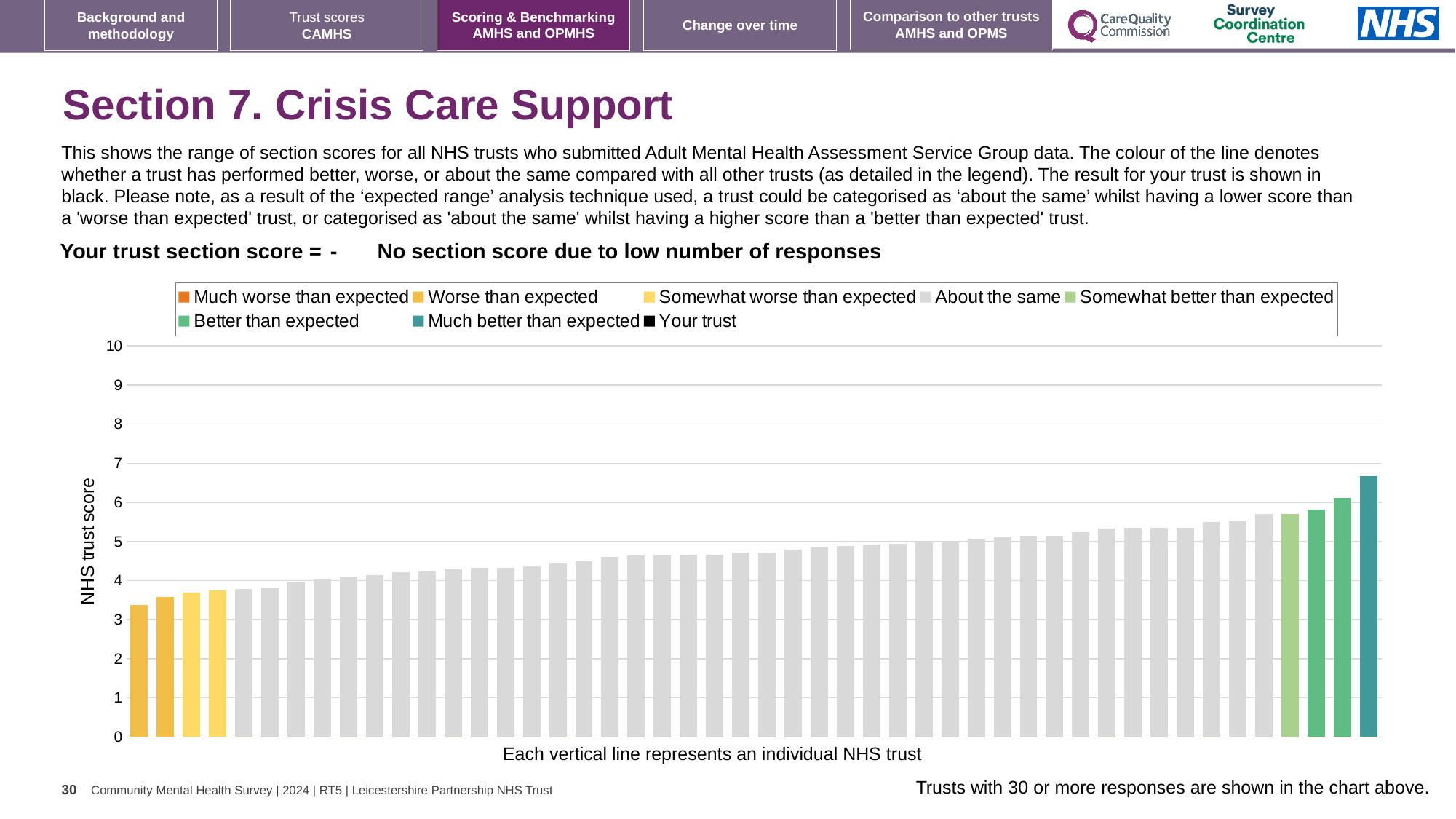
Which legend category does the tallest bar (rightmost, teal) belong to? Much better than expected What does each vertical line in the chart represent, according to the x-axis label? an individual NHS trust Is the value of the shortest bar in the chart greater or less than 3? greater What kind of chart is shown on the slide? bar chart Is the value of the tallest bar in the chart greater or less than 7? less How many entries does the chart legend list? 8 Do the bar values rise or fall from left to right along the x axis? rise Is the value of the shortest bar in the chart greater or less than 4? less What is the label on the vertical axis of the chart? NHS trust score What is the highest value shown on the vertical axis? 10 How many bars are coloured as 'Much better than expected'? 1